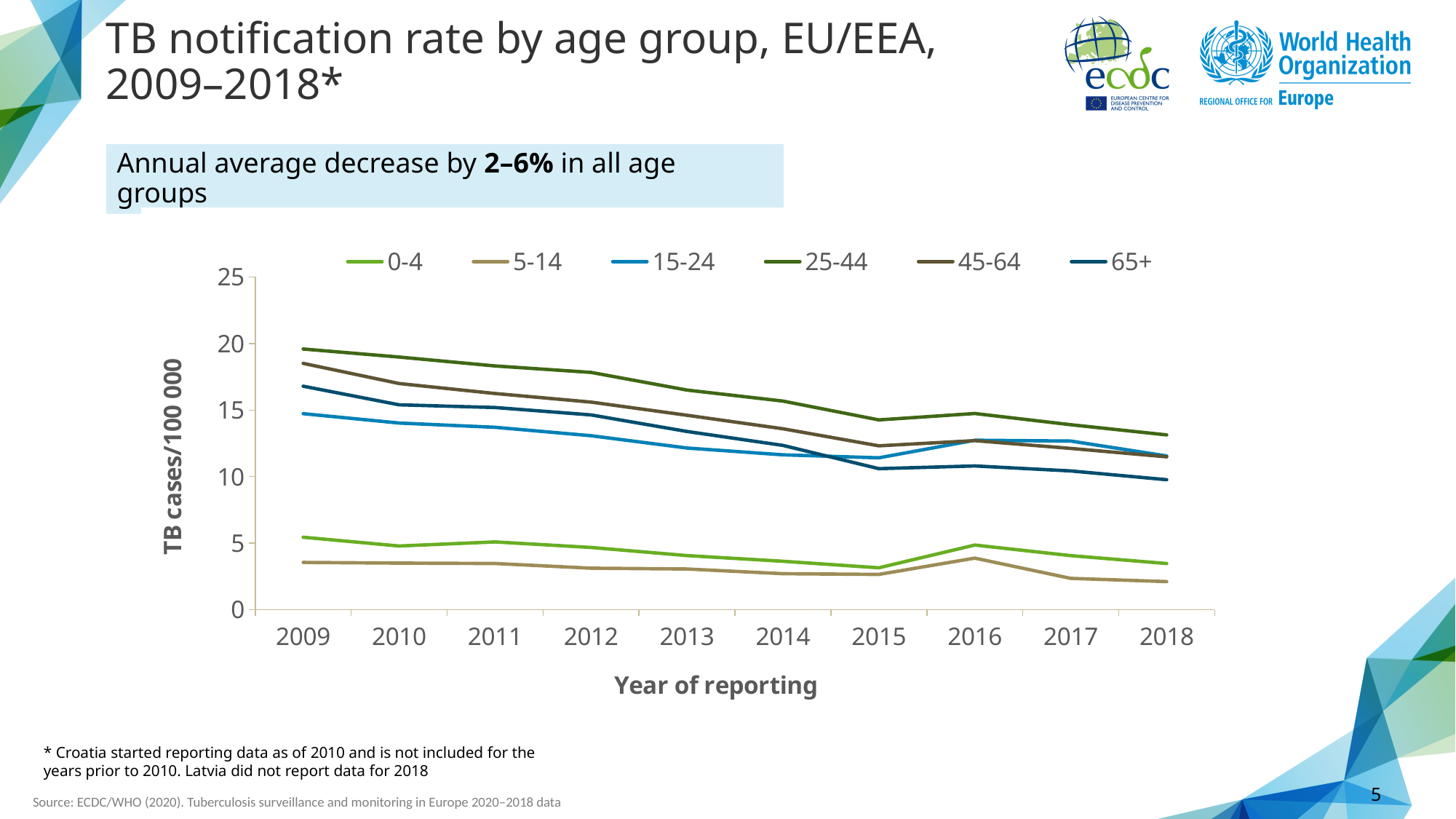
In 2009, which age group has the larger TB notification rate: 0-4 or 5-14? 0-4 How many years of reporting are shown on the x axis? 10 Is the value for the 5-14 age group in 2018 greater or less than 5? less Which age group had the lowest TB notification rate in 2018? 5-14 Is the value for the 65+ age group in 2009 greater or less than 15? greater How many age groups does the legend list? 6 Is the value for the 25-44 age group in 2009 greater or less than 15? greater In 2018, which age group has the larger TB notification rate: 15-24 or 65+? 15-24 What kind of chart is shown on the slide? line chart Which age group had the highest TB notification rate in 2009? 25-44 What is the title of the y axis? TB cases/100 000 Does the TB notification rate for the 25-44 age group rise or fall from 2009 to 2018? fall